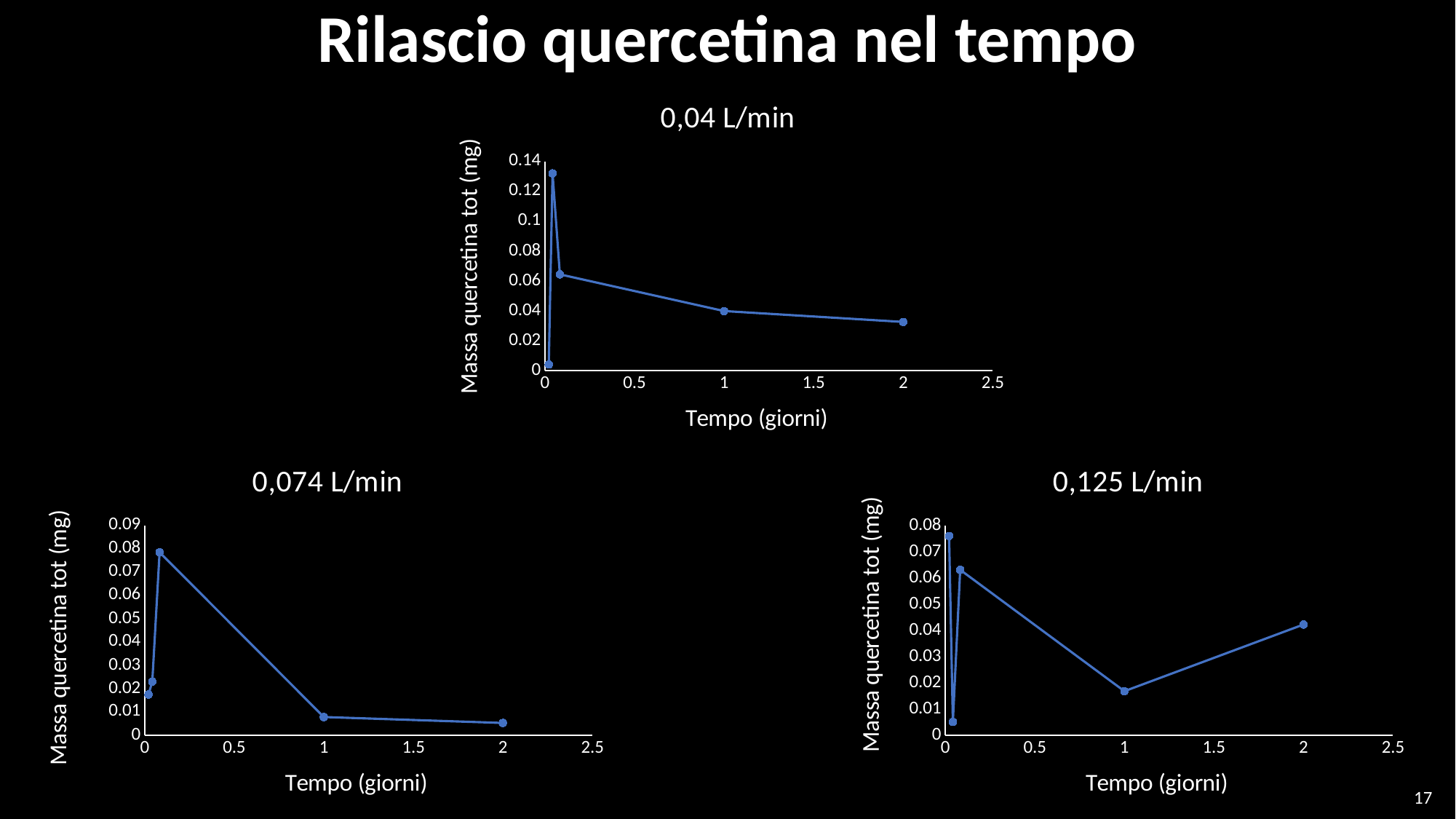
How many charts are shown on the slide? 3 In the chart titled 0,125 L/min, is the value at 2 days greater or less than 0.03? greater In the chart titled 0,125 L/min, does the value rise or fall between 1 day and 2 days? rise In the chart titled 0,04 L/min, does the value rise or fall between 1 day and 2 days? fall What is the y-axis title of the chart titled 0,074 L/min? Massa quercetina tot (mg) In the chart titled 0,04 L/min, is the highest point greater or less than 0.12? greater In the chart titled 0,04 L/min, is the value at 2 days greater or less than 0.04? less In the chart titled 0,125 L/min, which is larger: the value at 1 day or the value at 2 days? 2 days In the chart titled 0,074 L/min, how many data points are plotted? 5 What kind of chart is the one titled 0,04 L/min? line chart